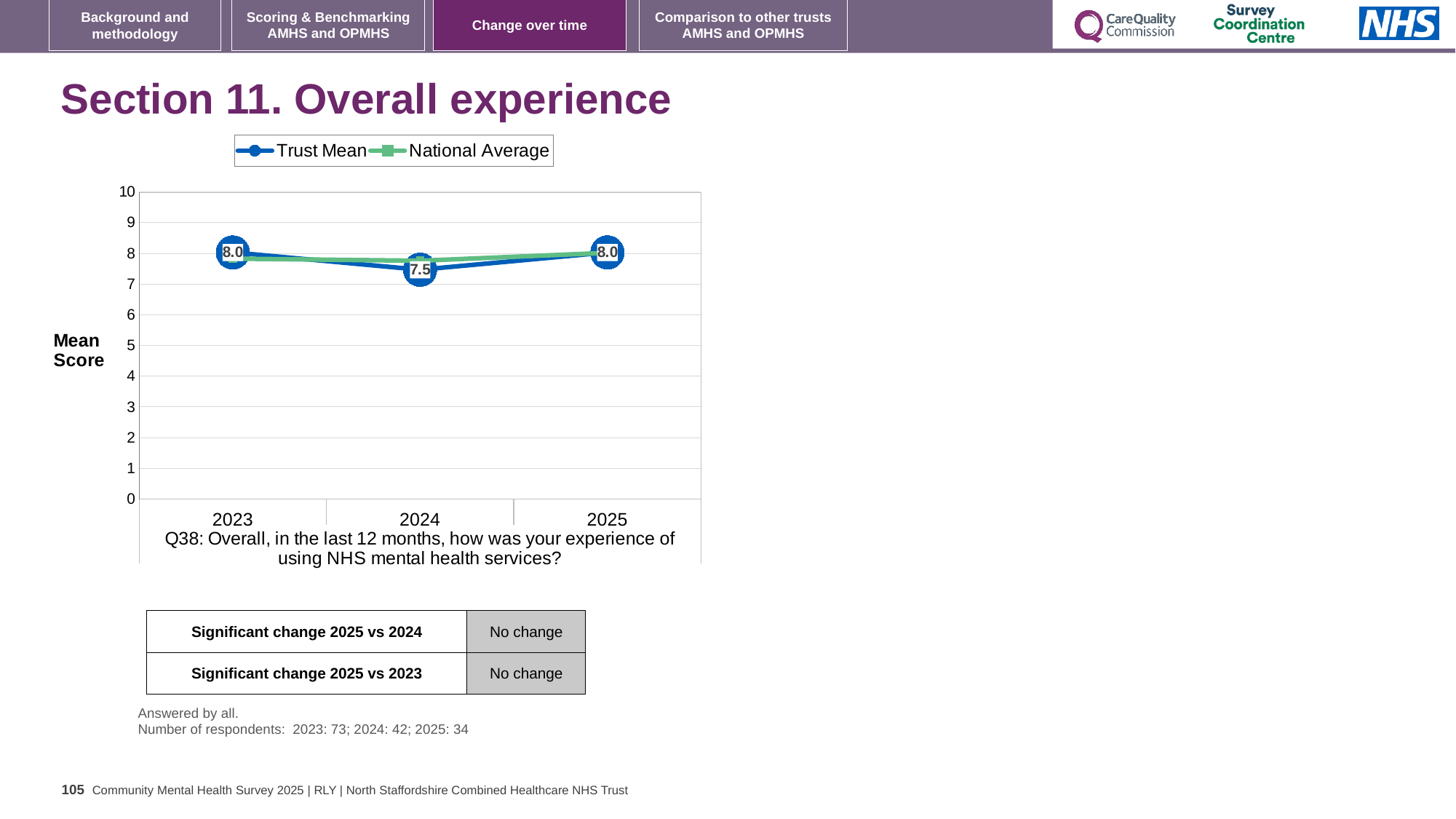
How many years are plotted on the x axis? 3 What kind of chart is shown on the slide? Line chart How many series does the legend list? 2 What is the Trust Mean value for 2023? 8.0 What are the two series named in the legend? Trust Mean and National Average What is the Trust Mean value for 2024? 7.5 Which is larger, the Trust Mean for 2023 or for 2024? 2023 Is the National Average value for 2024 greater or less than 5? greater In which year is the Trust Mean lowest? 2024 What is the Trust Mean value for 2025? 8.0 Does the Trust Mean rise or fall from 2023 to 2024? Fall What is the difference between the Trust Mean in 2025 and in 2024? 0.5